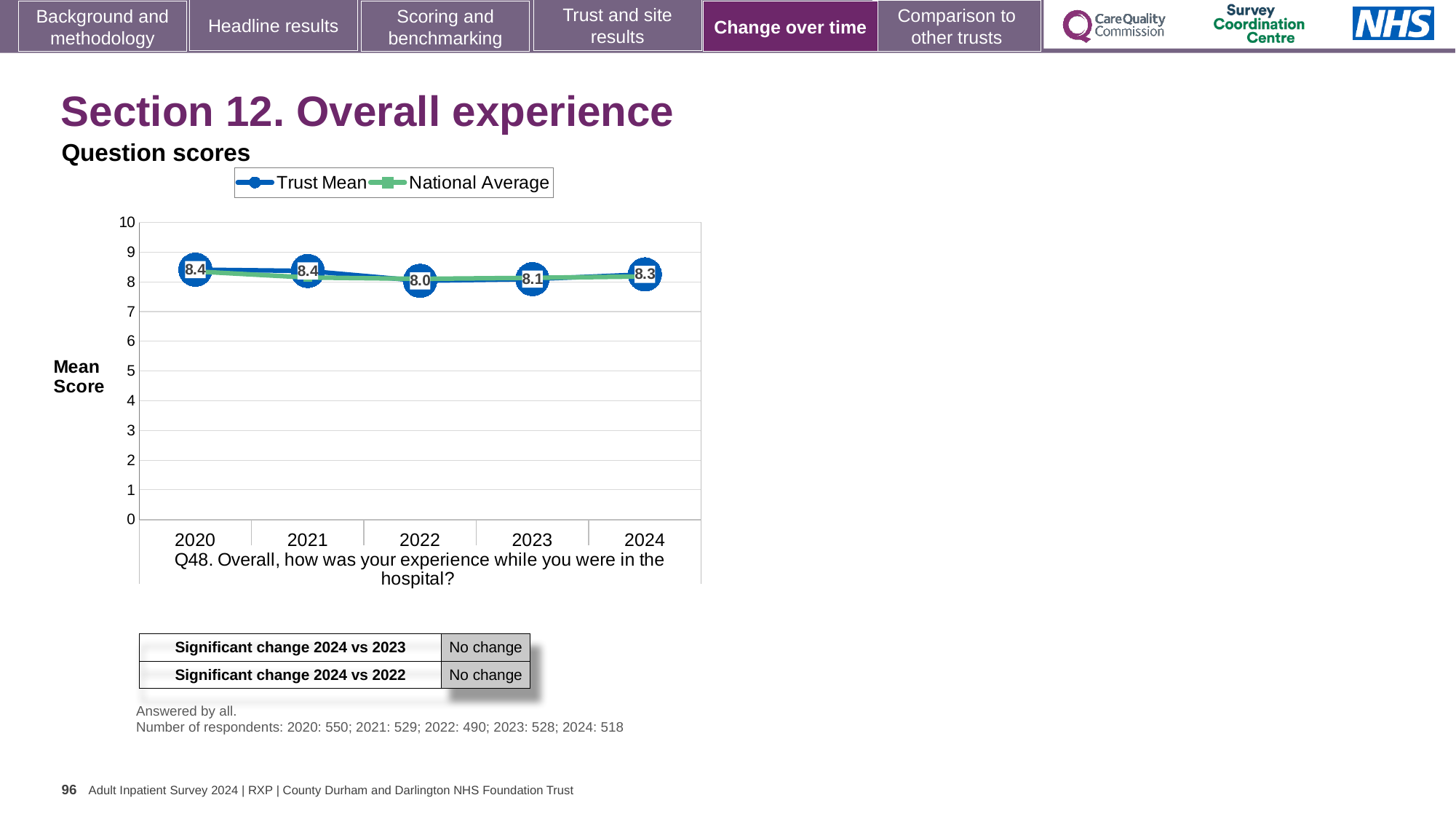
Which year has the larger Trust Mean score, 2023 or 2024? 2024 How many years are plotted on the x axis? 5 What is the Trust Mean score for 2024? 8.3 Is the National Average value for 2020 greater or less than 7? greater What is the difference between the Trust Mean score in 2024 and in 2022? 0.3 What kind of chart is shown on the slide? Line chart What is the Trust Mean score for 2023? 8.1 How many series does the legend list? 2 What is the Trust Mean score for 2022? 8.0 Does the Trust Mean score rise or fall from 2022 to 2024? Rise What is the Trust Mean score for 2020? 8.4 In which year is the Trust Mean score lowest? 2022